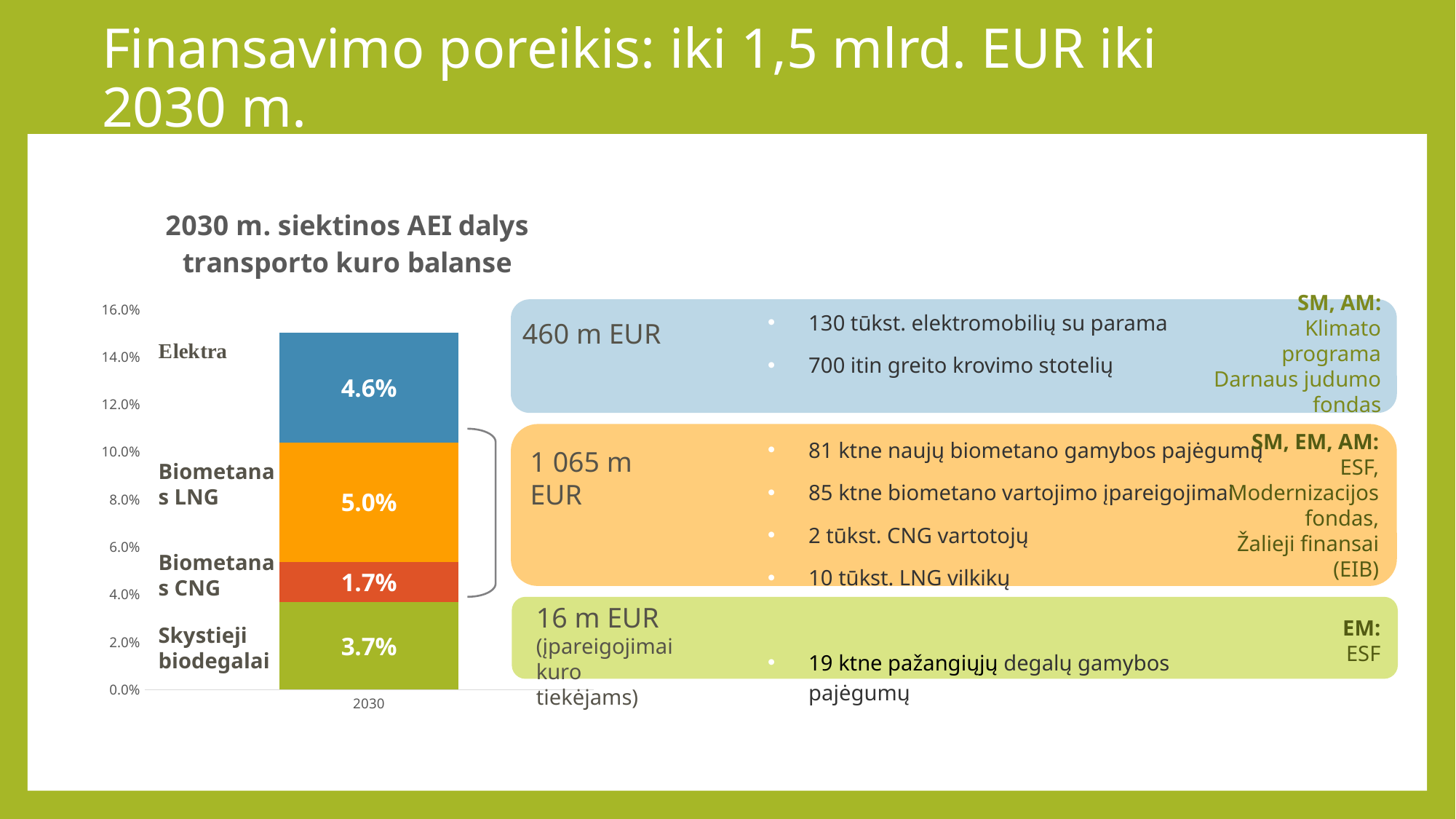
What is the value for Biometanas LNG in the 2030 bar? 5.0% What is the value for Skystieji biodegalai in the 2030 bar? 3.7% How many segments make up the 2030 stacked bar? 4 What is the difference between the Biometanas LNG and Biometanas CNG values? 3.3% What is the value for Elektra in the 2030 bar? 4.6% Which segment of the 2030 bar has the smallest value? Biometanas CNG What kind of chart is shown on the slide? stacked bar chart Which segment of the 2030 bar has the largest value? Biometanas LNG Which is larger, the value for Elektra or the value for Skystieji biodegalai? Elektra What is the total of the 2030 stacked bar? 15.0% What is the value for Biometanas CNG in the 2030 bar? 1.7% What is the chart's title? 2030 m. siektinos AEI dalys transporto kuro balanse